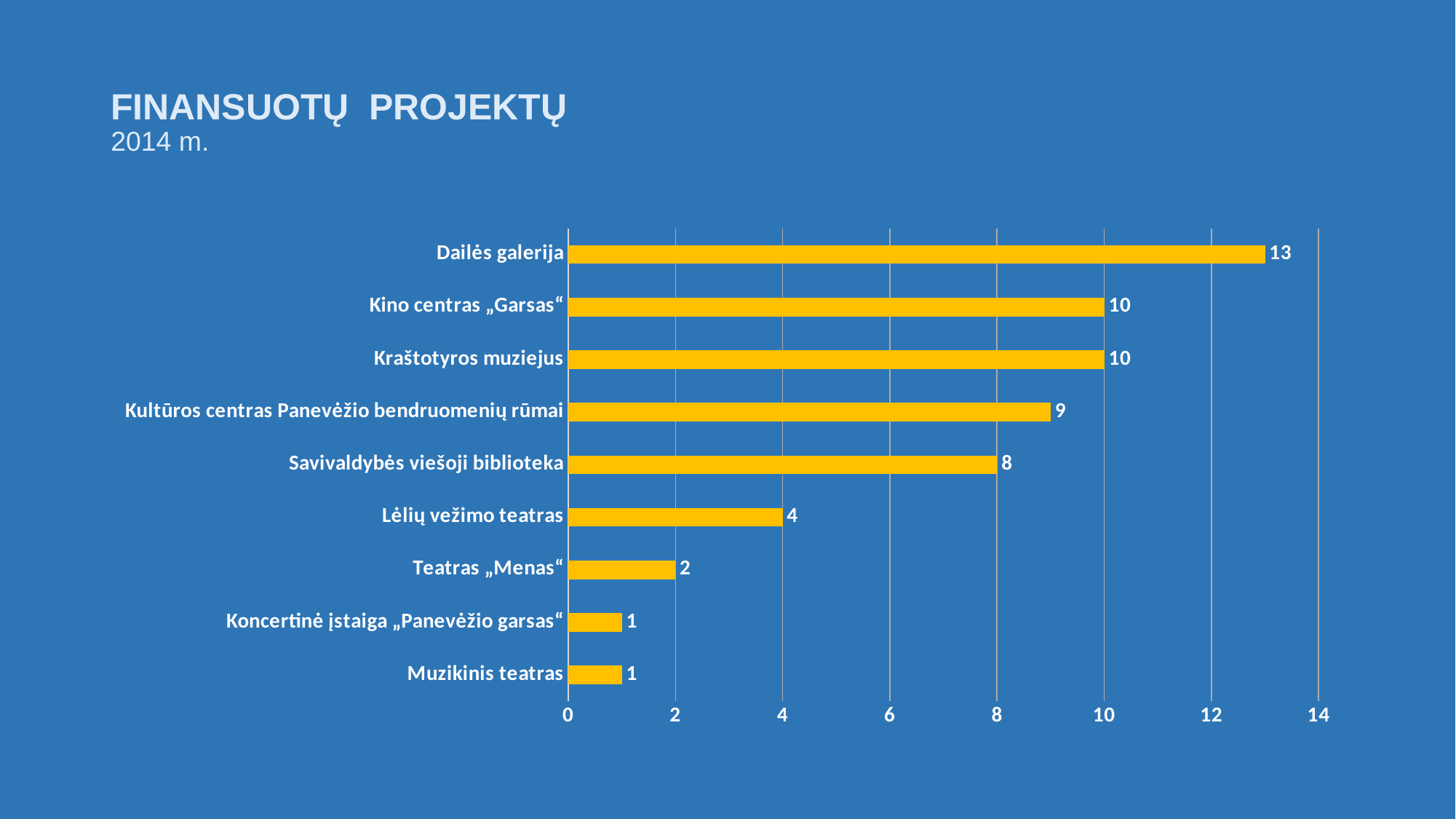
Is the value for Savivaldybės viešoji biblioteka greater or less than 6? greater What is the difference between the values for Savivaldybės viešoji biblioteka and Teatras „Menas“? 6 Which is larger, the value for Kraštotyros muziejus or the value for Kultūros centras Panevėžio bendruomenių rūmai? Kraštotyros muziejus What is the title of the slide? FINANSUOTŲ PROJEKTŲ 2014 m. What kind of chart is shown on the slide? bar chart What is the difference between the values for Dailės galerija and Kino centras „Garsas“? 3 Which category has the highest value? Dailės galerija What is the value for Lėlių vežimo teatras? 4 What is the value for Dailės galerija? 13 What is the value for Savivaldybės viešoji biblioteka? 8 What is the value for Kultūros centras Panevėžio bendruomenių rūmai? 9 How many categories are shown in the chart? 9